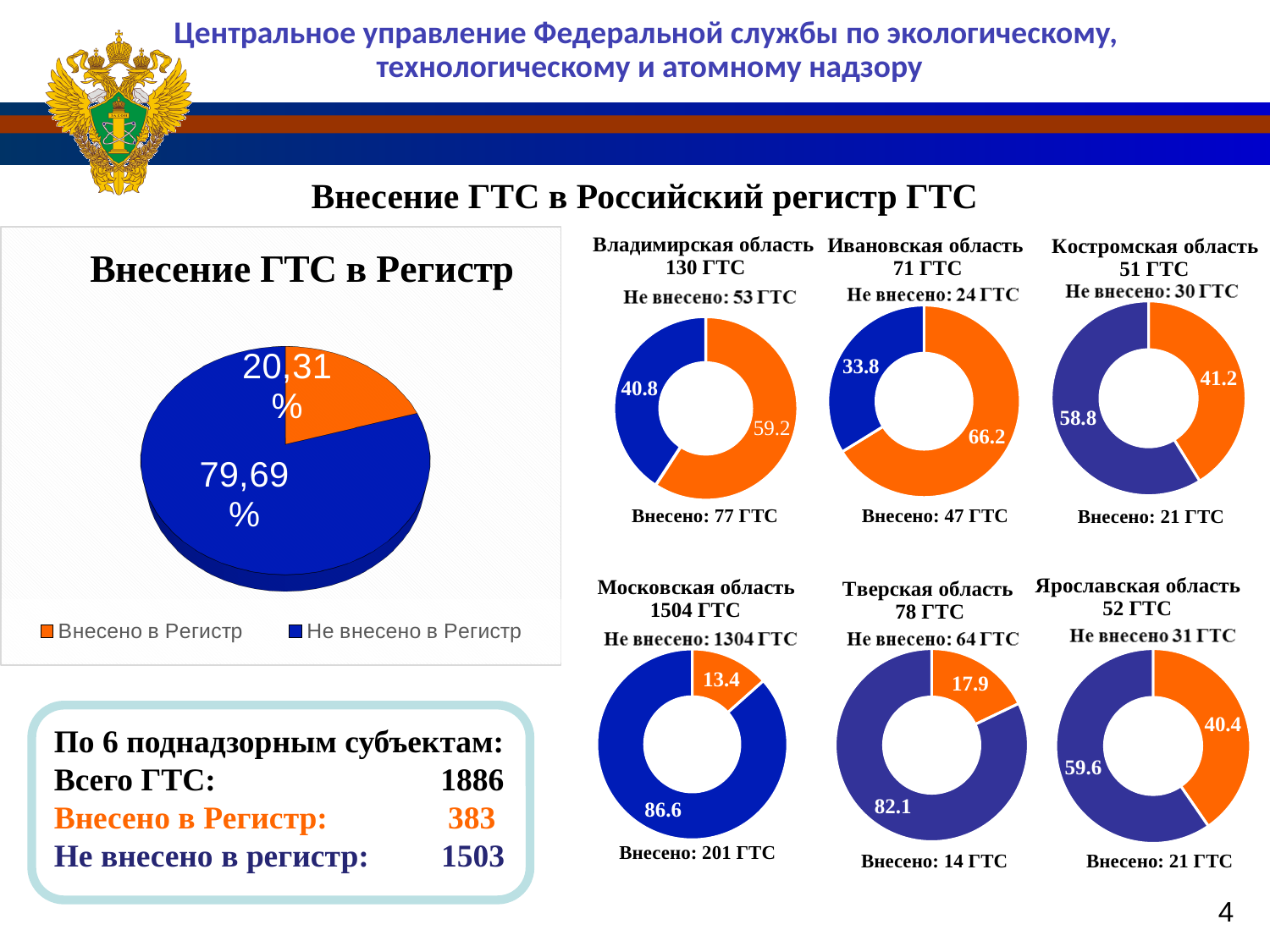
How many regional donut charts are shown on the slide? 6 In the pie chart titled 'Внесение ГТС в Регистр', what percentage is shown for 'Внесено в Регистр'? 20,31% In the donut chart for 'Тверская область', what value is shown on the blue slice? 82.1 Which region has a larger orange slice value: 'Владимирская область' or 'Костромская область'? Владимирская область In the donut chart for 'Московская область', what value is shown on the orange slice? 13.4 How many entries does the legend of the chart titled 'Внесение ГТС в Регистр' list? 2 In the donut chart for 'Костромская область', what value is shown on the blue slice? 58.8 Among the six regional donut charts, which region has the largest orange slice? Ивановская область In the pie chart titled 'Внесение ГТС в Регистр', what percentage is shown for 'Не внесено в Регистр'? 79,69% What kind of chart is the chart titled 'Внесение ГТС в Регистр'? pie chart In the donut chart for 'Ярославская область', what is the difference between the blue slice value and the orange slice value? 19.2 Among the six regional donut charts, which region has the smallest orange slice? Московская область